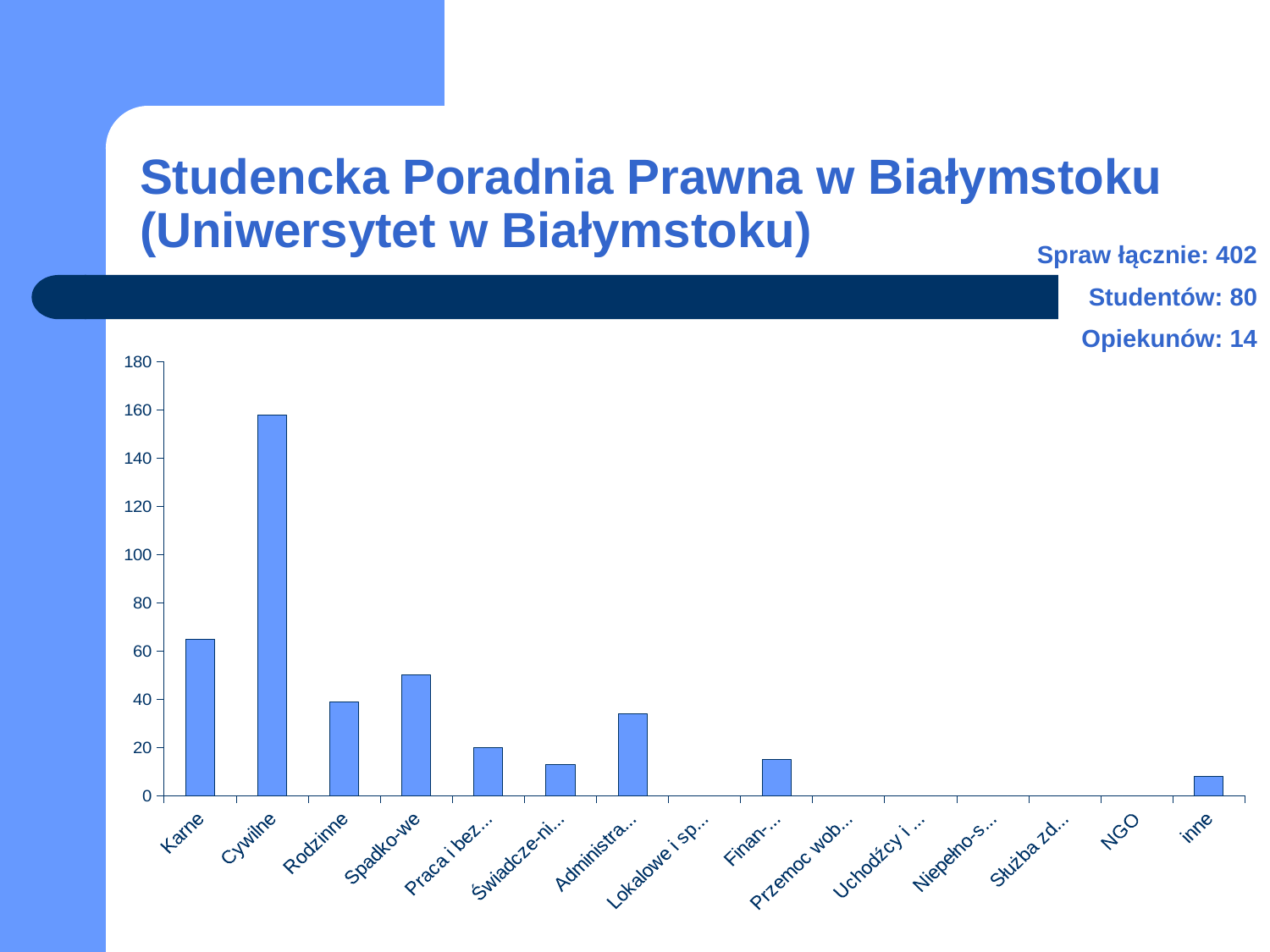
Which is larger, the value for Karne or the value for Spadko-we? Karne Which category has the highest bar? Cywilne What colour are the bars in the chart? blue Is the value for inne greater or less than 20? less How many categories are shown on the x axis? 15 Is the value for Cywilne greater or less than 140? greater Which is larger, the value for Rodzinne or the value for Cywilne? Cywilne Is the value for Rodzinne greater or less than 20? greater What is the value for NGO? 0 What kind of chart is shown on the slide? bar chart